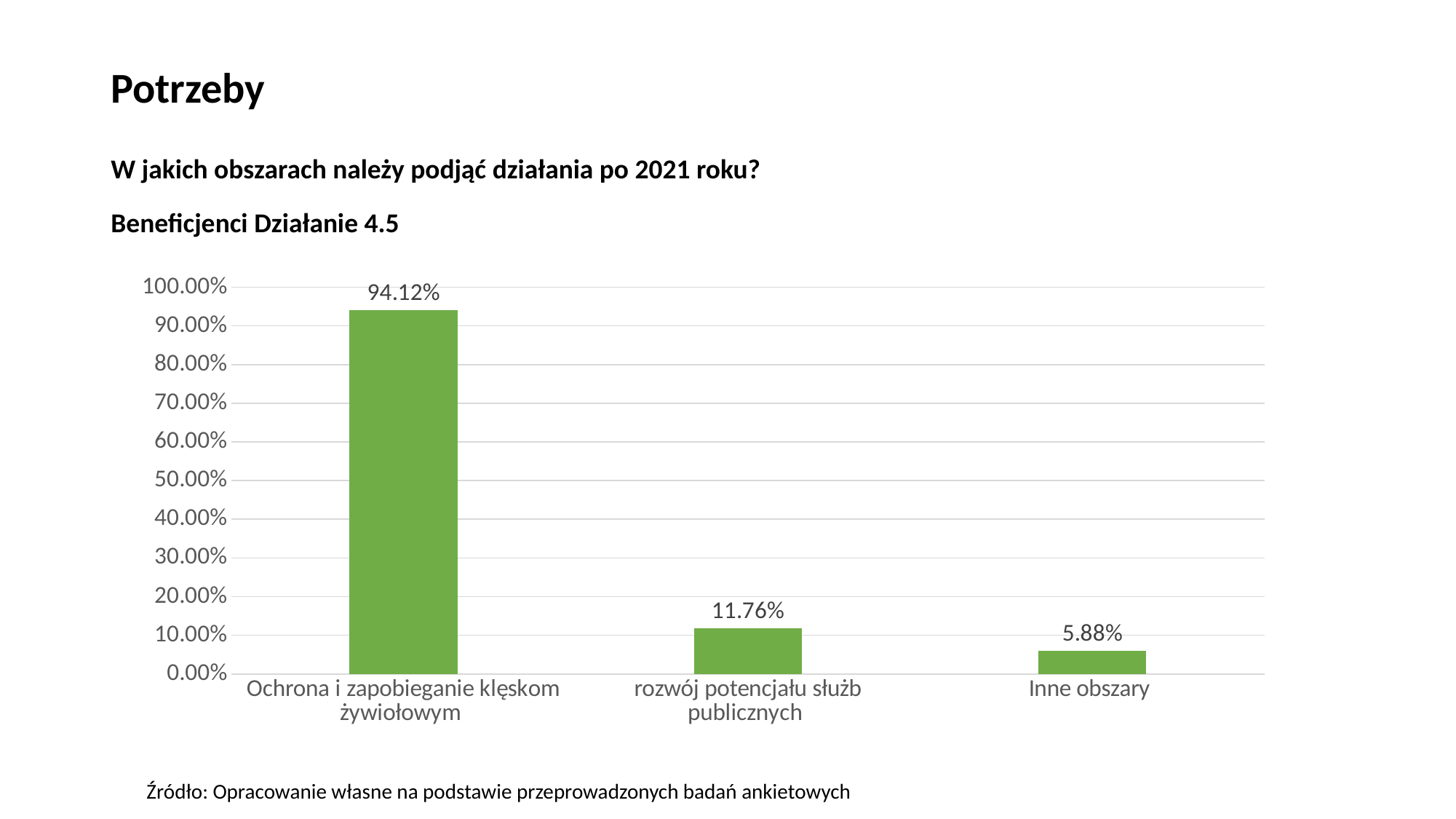
Which is larger, the value for "rozwój potencjału służb publicznych" or the value for "Inne obszary"? rozwój potencjału służb publicznych What is the value for "Inne obszary"? 5.88% Which category has the highest value? Ochrona i zapobieganie klęskom żywiołowym What is the difference between the values for "rozwój potencjału służb publicznych" and "Inne obszary"? 5.88% What is the highest value shown on the vertical axis? 100.00% What is the value for "Ochrona i zapobieganie klęskom żywiołowym"? 94.12% Which category has the lowest value? Inne obszary What kind of chart is shown on the slide? Bar chart What is the difference between the values for "Ochrona i zapobieganie klęskom żywiołowym" and "rozwój potencjału służb publicznych"? 82.36% Is the value for "Ochrona i zapobieganie klęskom żywiołowym" greater or less than 90.00%? greater How many categories are shown on the chart? 3 What is the value for "rozwój potencjału służb publicznych"? 11.76%